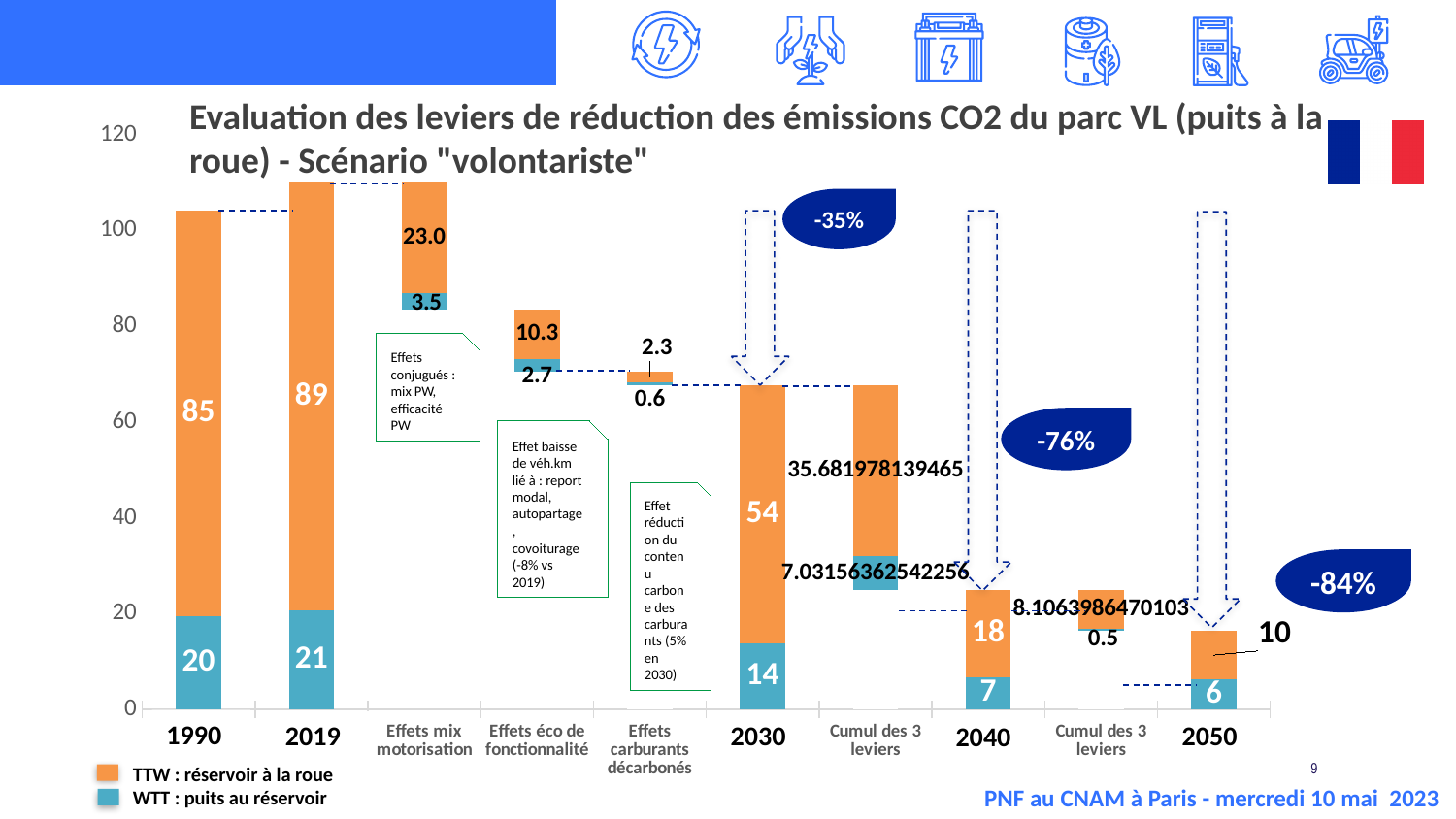
What is the TTW value for 2030? 54 Which year bar has the highest TTW value? 2019 What is the total of the stacked bar for 2040? 25 What is the TTW value for 1990? 85 Which is larger, the WTT value for 2030 or the WTT value for 2040? 2030 What kind of chart is shown on the slide? Stacked bar chart What is the WTT value for 2019? 21 What is the WTT value for 2050? 6 How many series does the legend list? 2 What is the difference between the TTW values for 2019 and 1990? 4 Which colour represents the WTT series in the legend? Teal What is the total of the stacked bar for 2019? 110